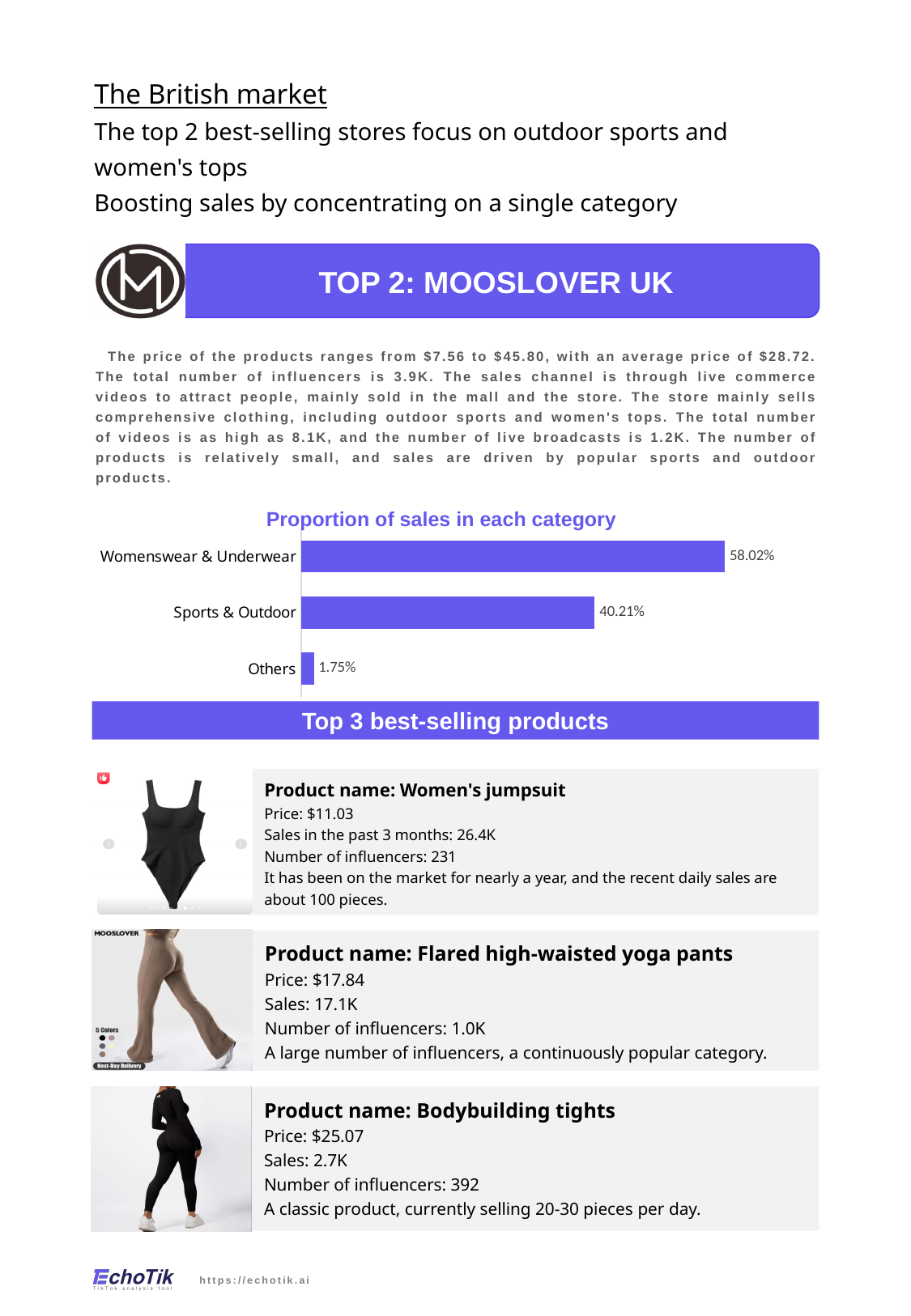
What is the value for Others in the 'Proportion of sales in each category' chart? 1.75% What is the difference between the Sports & Outdoor and Others values in the chart? 38.46% How many categories are shown in the 'Proportion of sales in each category' chart? 3 Which category has the highest proportion of sales in the chart? Womenswear & Underwear Are the bars in the 'Proportion of sales in each category' chart horizontal or vertical? Horizontal Which is larger in the chart: Sports & Outdoor or Others? Sports & Outdoor What is the difference between the Womenswear & Underwear and Sports & Outdoor values in the chart? 17.81% What kind of chart is 'Proportion of sales in each category'? Bar chart What is the value for Womenswear & Underwear in the 'Proportion of sales in each category' chart? 58.02% Which category has the lowest proportion of sales in the chart? Others What is the title of the chart on the slide? Proportion of sales in each category What is the value for Sports & Outdoor in the 'Proportion of sales in each category' chart? 40.21%